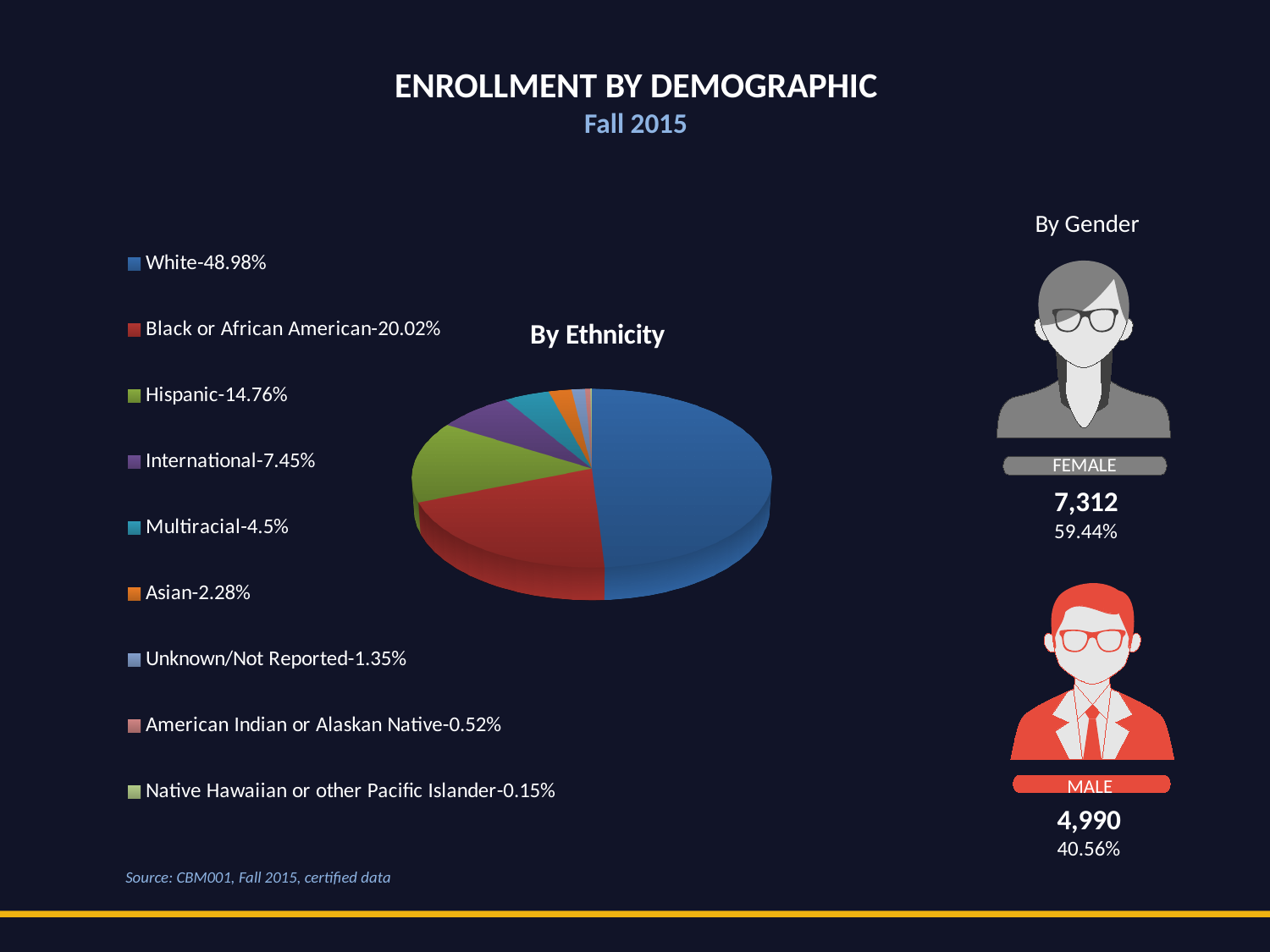
In the "By Ethnicity" pie chart, which category has the smallest share? Native Hawaiian or other Pacific Islander In the "By Ethnicity" pie chart, what is the difference in percentage points between White and Black or African American? 28.96 In the "By Ethnicity" pie chart, what percentage is shown for Hispanic? 14.76% In the "By Ethnicity" pie chart, which is larger: Multiracial or Asian? Multiracial In the "By Ethnicity" pie chart, what percentage is shown for Unknown/Not Reported? 1.35% In the "By Ethnicity" pie chart, what percentage is shown for White? 48.98% What is the title of the pie chart on the slide? By Ethnicity What type of chart is the "By Ethnicity" chart? pie chart How many ethnicity categories are listed in the legend of the "By Ethnicity" pie chart? 9 In the "By Ethnicity" pie chart, which category has the largest share? White In the "By Ethnicity" pie chart, what percentage is shown for International? 7.45% In the "By Ethnicity" pie chart, what is the difference in percentage points between Hispanic and International? 7.31